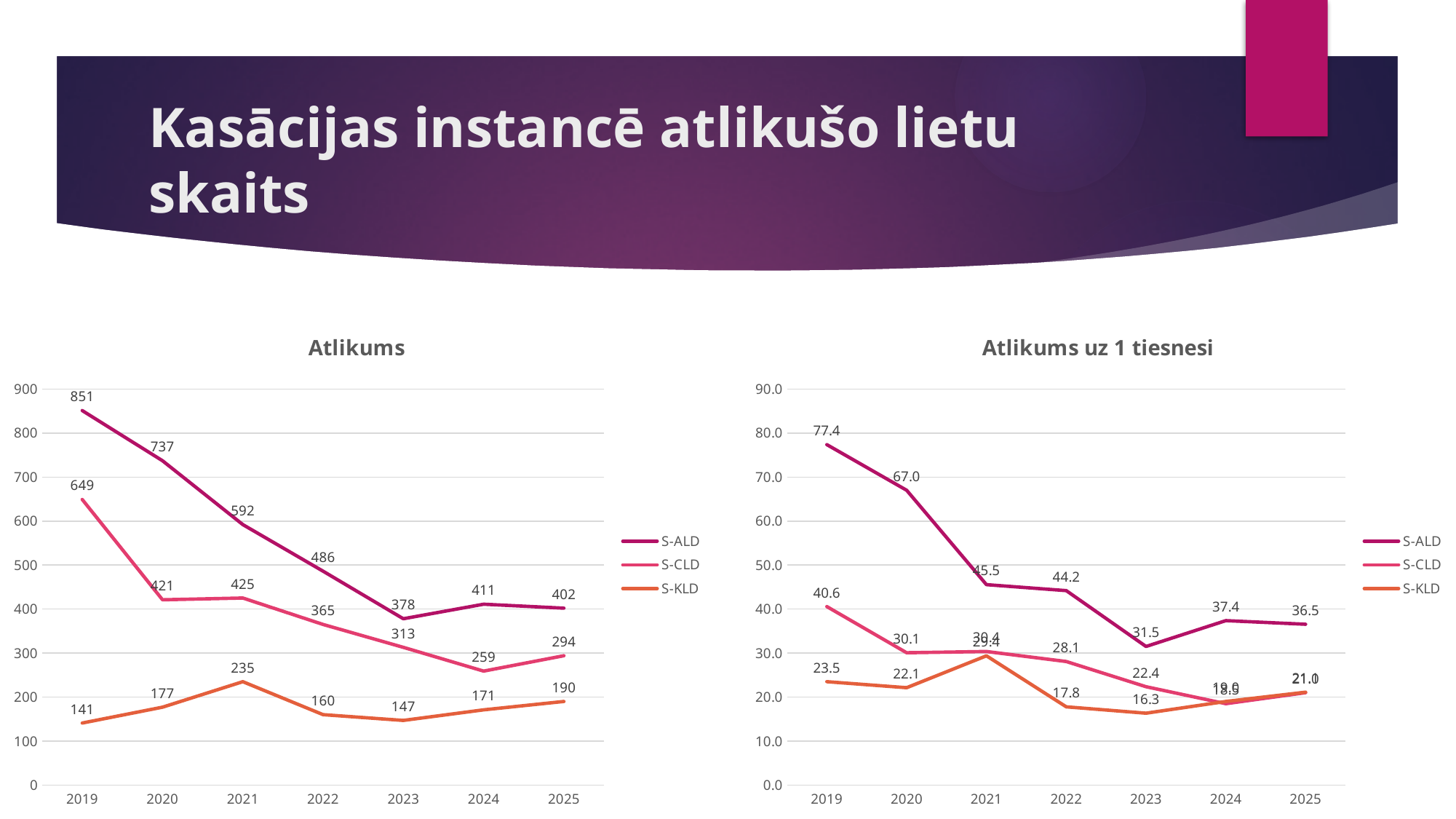
In the 'Atlikums' chart, how many years are shown on the x axis? 7 In the 'Atlikums uz 1 tiesnesi' chart, what is the value for S-ALD in 2019? 77.4 In the 'Atlikums' chart, what is the value for S-KLD in 2021? 235 What kind of chart is the 'Atlikums' chart? line chart In the 'Atlikums' chart, what is the difference between the S-ALD values for 2019 and 2025? 449 In the 'Atlikums uz 1 tiesnesi' chart, what is the difference between the S-ALD values for 2019 and 2020? 10.4 How many series does the legend of the 'Atlikums uz 1 tiesnesi' chart list? 3 In the 'Atlikums' chart, in which year is the S-CLD value highest? 2019 In the 'Atlikums uz 1 tiesnesi' chart, in which year is the S-KLD value lowest? 2023 In the 'Atlikums' chart, what is the value for S-ALD in 2019? 851 In the 'Atlikums' chart, does the S-ALD value rise or fall from 2019 to 2023? fall In the 'Atlikums uz 1 tiesnesi' chart, what is the value for S-CLD in 2020? 30.1